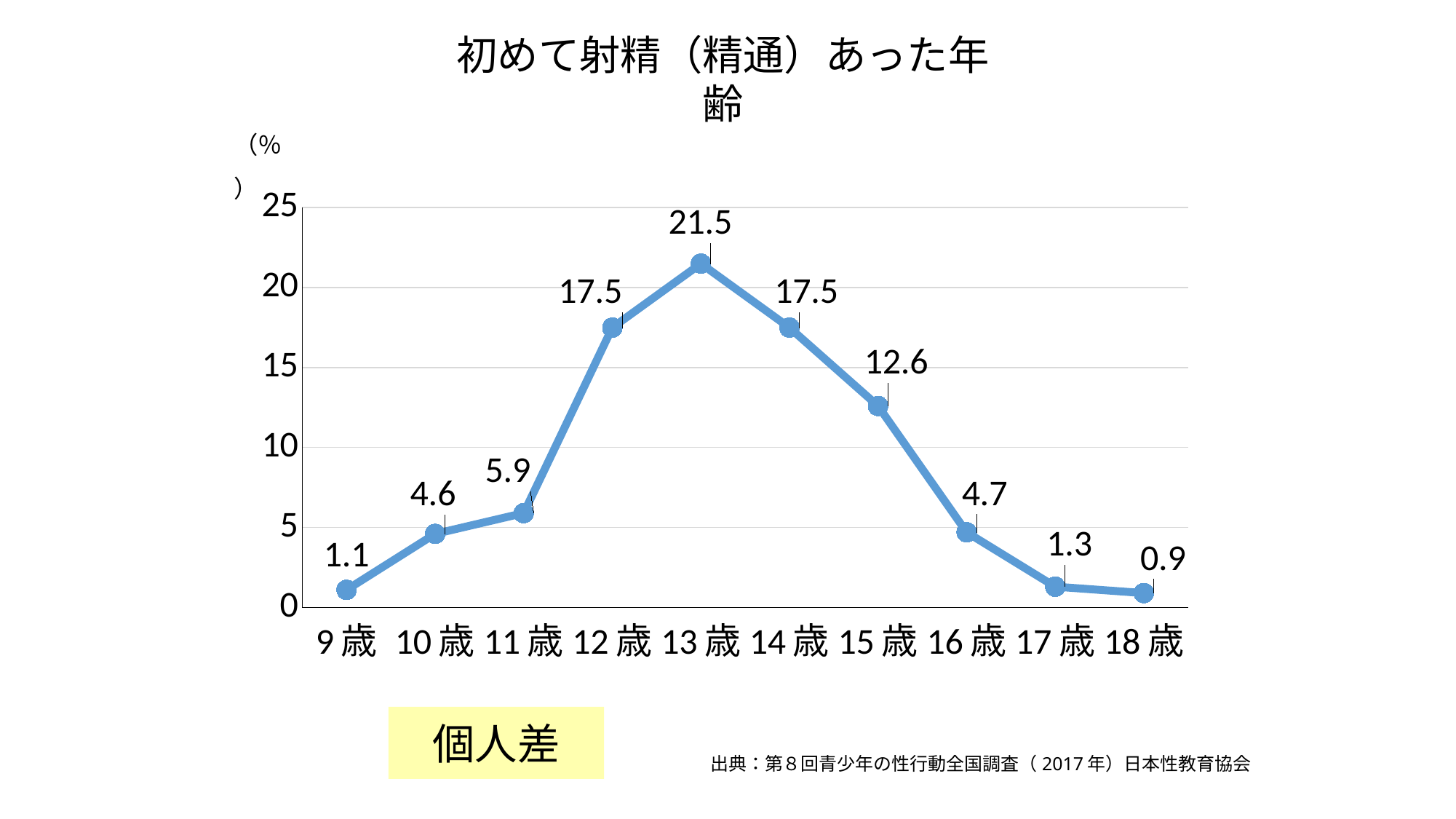
What kind of chart is shown? line chart Which age has the lowest value? 18歳 Which age has the highest value? 13歳 What is the difference between the values for 13歳 and 15歳? 8.9 Which is larger, the value for 11歳 or the value for 16歳? 11歳 What is the value for 13歳? 21.5 Do the values rise or fall from 13歳 to 18歳? fall What is the value for 9歳? 1.1 What is the value for 15歳? 12.6 How many age categories are plotted on the x axis? 10 Is the value for 12歳 greater or less than 15? greater What unit is shown on the y axis? %